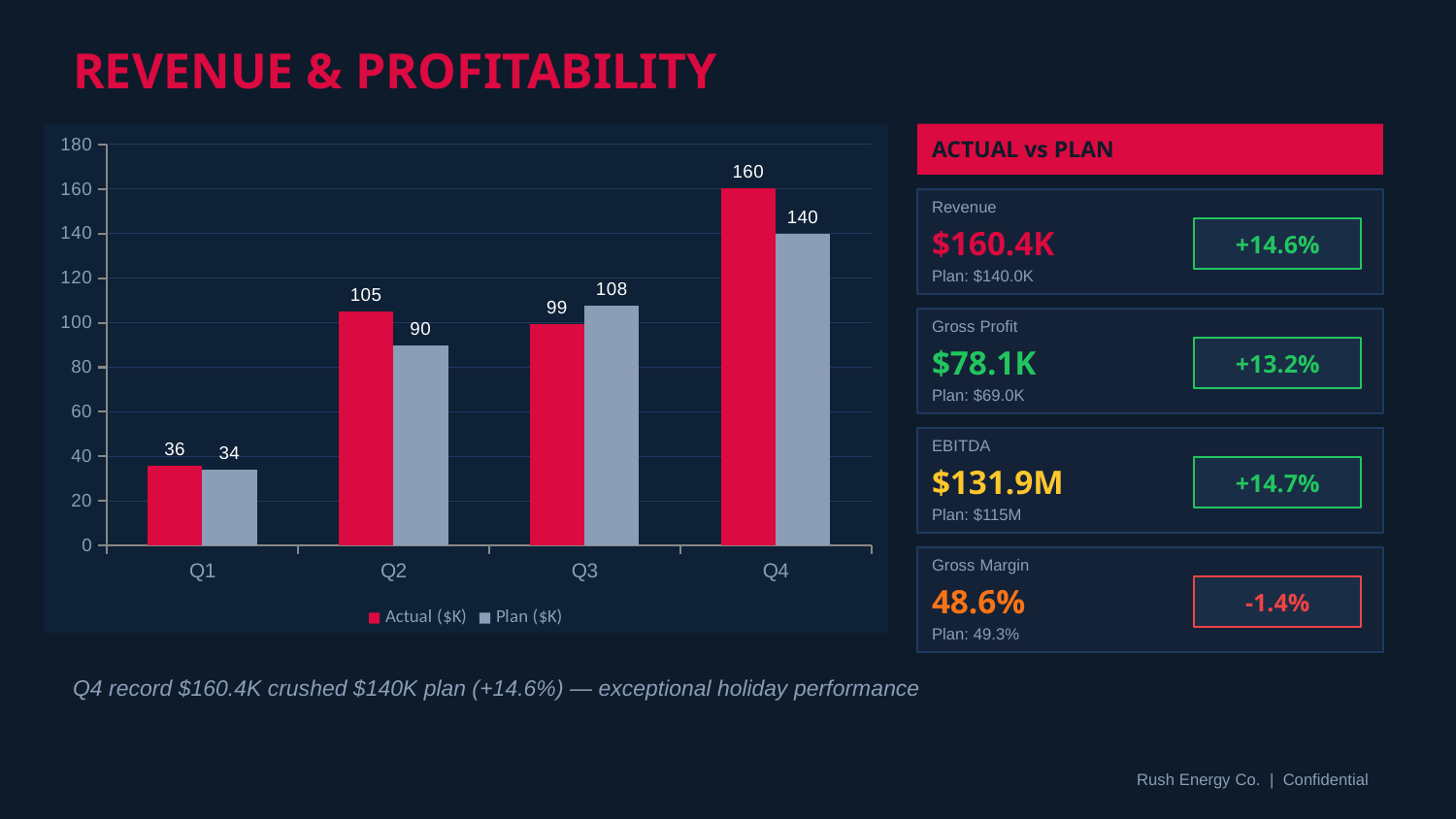
What colour are the Actual ($K) bars? Red Which quarter has the lowest Plan ($K) value? Q1 How many series does the legend list? 2 What is the Actual ($K) value for Q1? 36 In Q3, which is larger, the Actual ($K) value or the Plan ($K) value? Plan ($K) What is the difference between the Actual and Plan values for Q4? 20 What kind of chart is shown on the slide? Bar chart Is the Actual ($K) value for Q2 greater or less than 100? greater Which quarter has the highest Actual ($K) value? Q4 What is the Plan ($K) value for Q2? 90 What is the Actual ($K) value for Q4? 160 How many quarters are shown on the x axis? 4